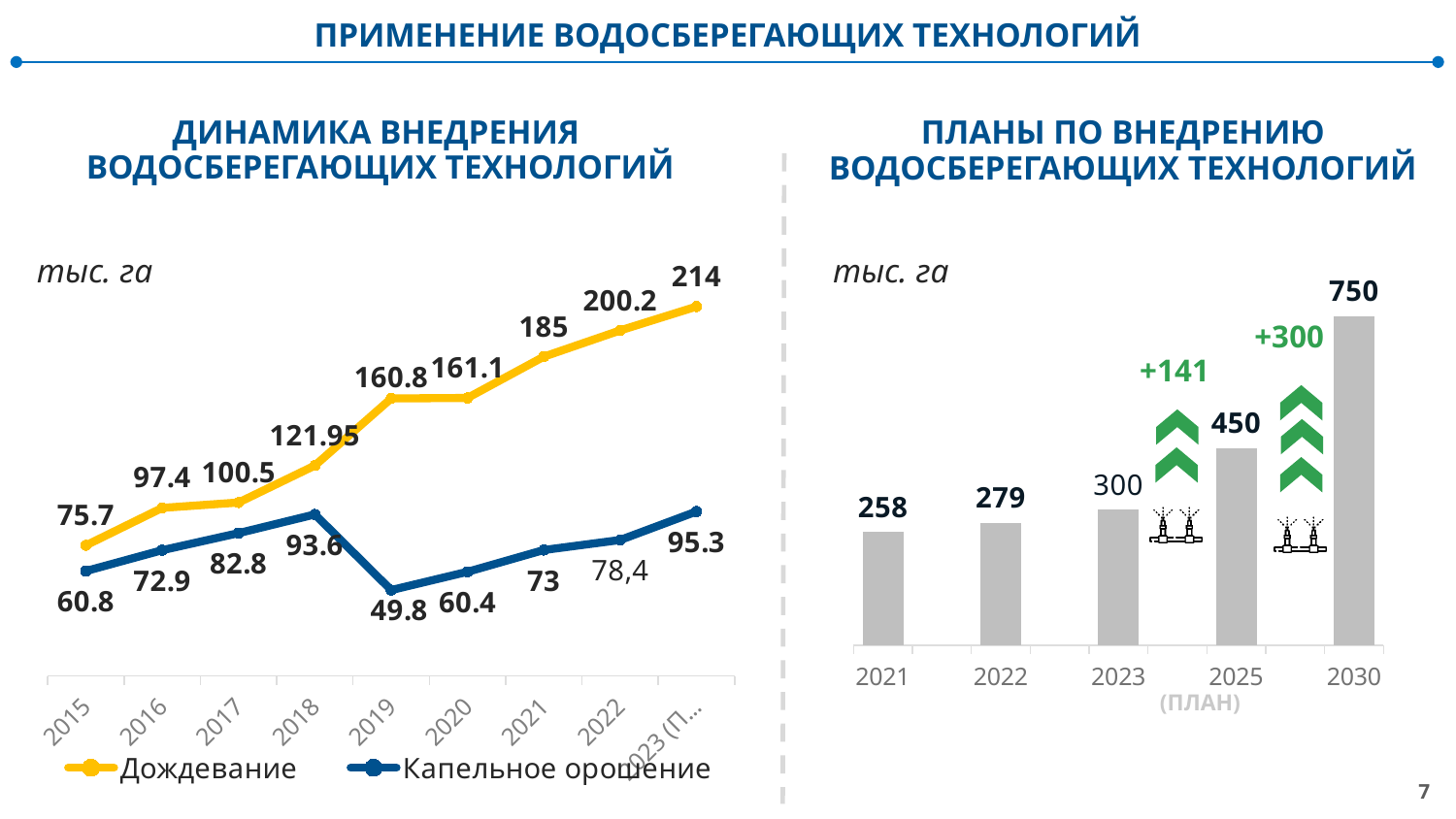
On the left chart (ДИНАМИКА ВНЕДРЕНИЯ ВОДОСБЕРЕГАЮЩИХ ТЕХНОЛОГИЙ), what is the value for Дождевание in 2018? 121.95 On the right chart, how many bars are shown? 5 On the right chart, what is the difference between the values for 2022 and 2021? 21 On the left chart, in which year is Капельное орошение at its lowest? 2019 On the left chart, how many series does the legend list? 2 On the left chart, which series has the higher value in 2021, Дождевание or Капельное орошение? Дождевание On the left chart, does the Дождевание series rise or fall from 2015 to 2023? Rise On the right chart, which year has the highest value? 2030 What kind of chart is the left chart? Line chart On the right chart (ПЛАНЫ ПО ВНЕДРЕНИЮ ВОДОСБЕРЕГАЮЩИХ ТЕХНОЛОГИЙ), what is the value for 2025? 450 On the left chart, what is the value for Капельное орошение in 2019? 49.8 On the left chart, what is the difference between Дождевание and Капельное орошение in 2022? 121.8